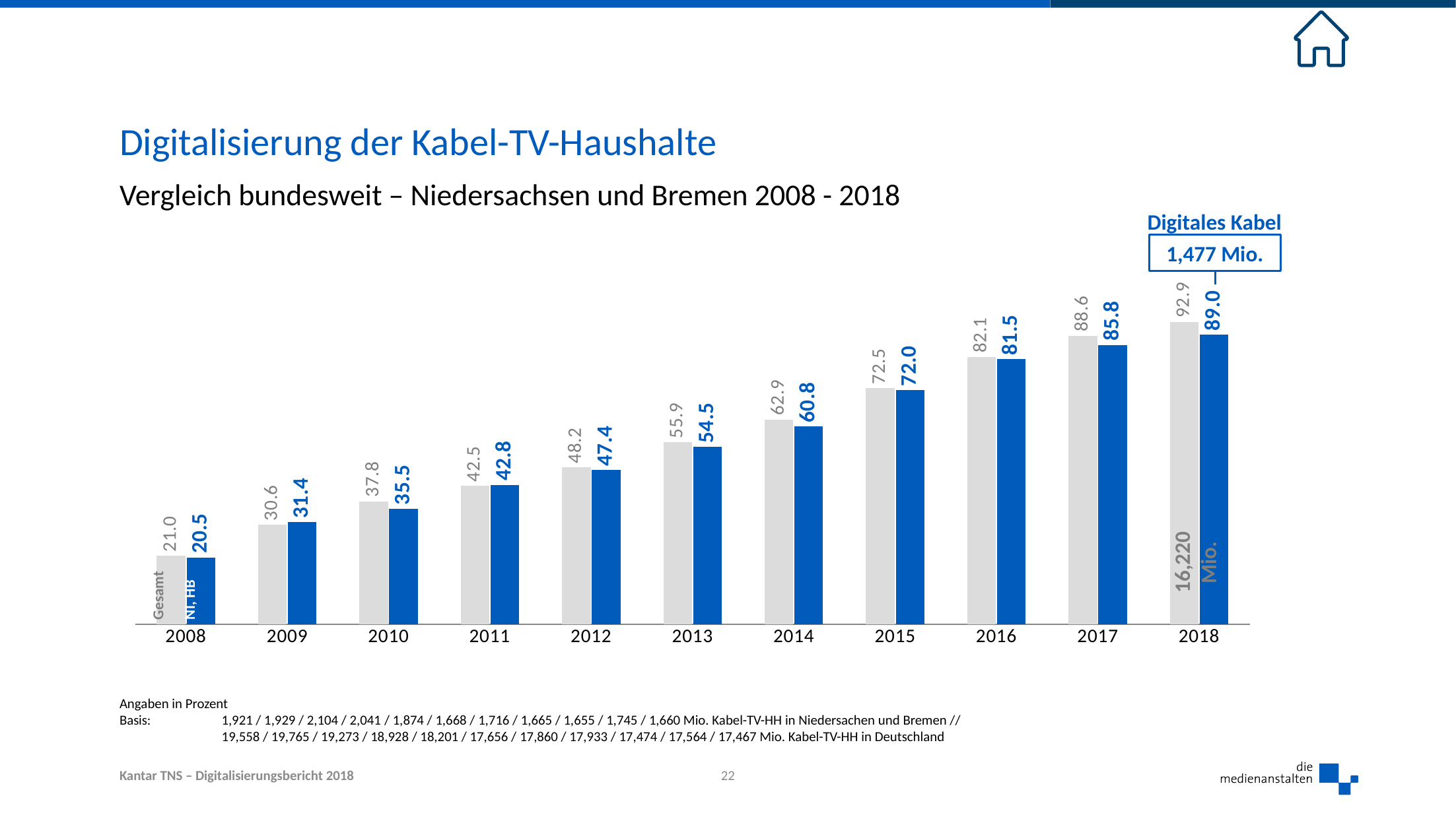
What kind of chart is shown on the slide? bar chart What is the NI, HB value for 2015? 72.0 Which is larger in 2009, the Gesamt value or the NI, HB value? NI, HB What is the NI, HB value for 2008? 20.5 Which is larger in 2010, the Gesamt value or the NI, HB value? Gesamt In which year is the Gesamt value highest? 2018 How many years are shown on the x axis? 11 In which year is the NI, HB value lowest? 2008 How many series does the chart show? 2 What is the difference between the Gesamt and NI, HB values in 2018? 3.9 What is the Gesamt value for 2012? 48.2 Do the NI, HB values rise or fall from 2008 to 2018? rise